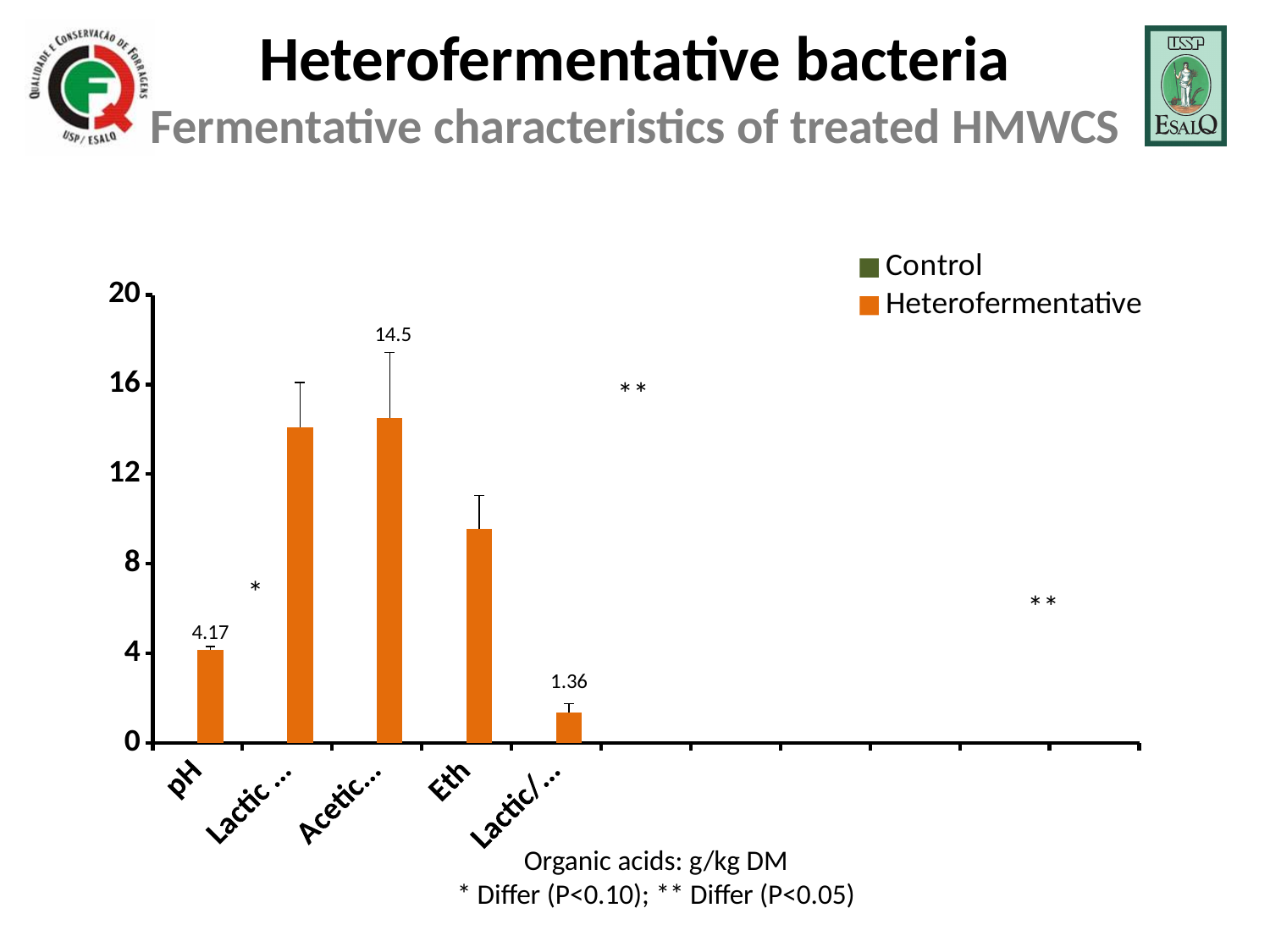
What value is labelled on the rightmost bar (Lactic/...)? 1.36 Is the value for Eth greater or less than 8? greater Is the value for Eth greater or less than 12? less How many series does the legend list? 2 What value is labelled on the Acetic bar? 14.5 Which is larger, the pH bar or the Eth bar? Eth What colour is used for the Heterofermentative series in the legend? orange Which category has the lowest bar? Lactic/... What kind of chart is shown on the slide? bar chart How many bars are plotted on the chart? 5 What is the difference between the Acetic value and the pH value? 10.33 What is the value of the pH bar? 4.17